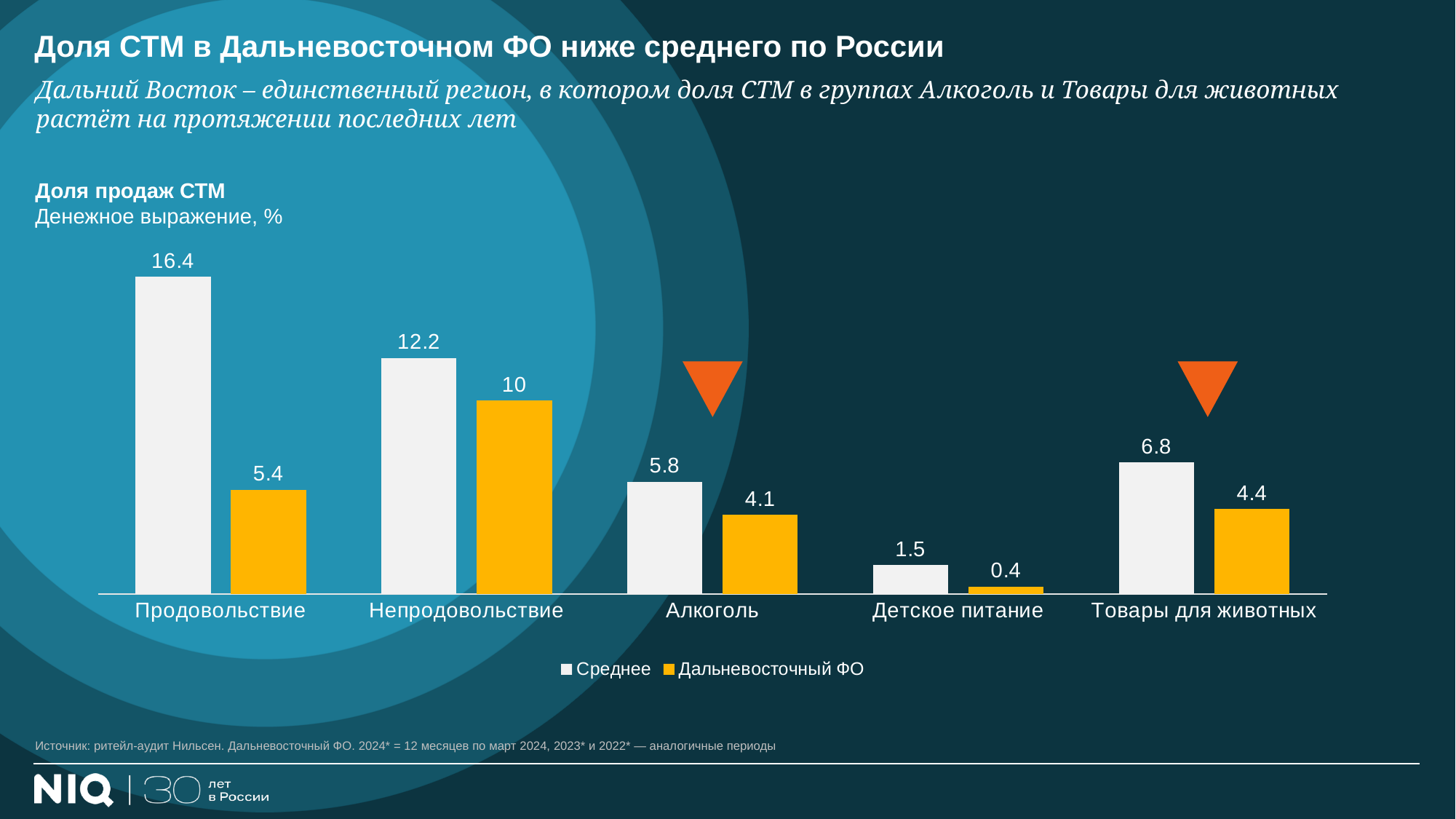
Which category has the lowest value for Дальневосточный ФО? Детское питание What is the value for Дальневосточный ФО in the Непродовольствие category? 10 What kind of chart is shown on the slide? Bar chart What is the value for Среднее in the Продовольствие category? 16.4 What is the value for Дальневосточный ФО in the Детское питание category? 0.4 How many series does the legend list? 2 What is the difference between Среднее and Дальневосточный ФО in the Продовольствие category? 11 How many categories are shown on the x axis? 5 What colour represents the Дальневосточный ФО series? Orange Which is larger in the Товары для животных category: Среднее or Дальневосточный ФО? Среднее What is the difference between Среднее and Дальневосточный ФО in the Алкоголь category? 1.7 Which category has the highest value for Среднее? Продовольствие